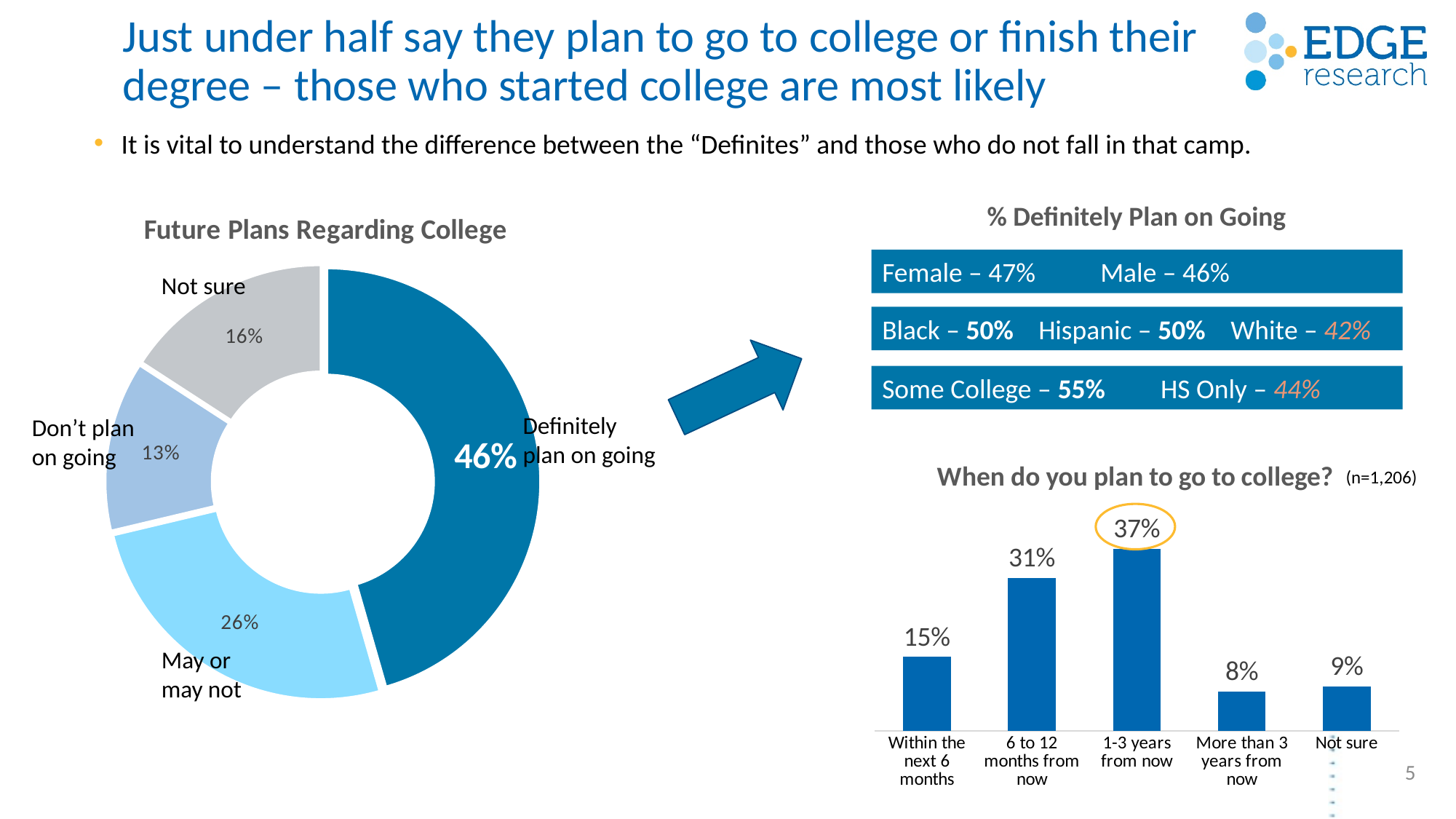
In the 'When do you plan to go to college?' chart, what is the difference between '1-3 years from now' and '6 to 12 months from now'? 6% What kind of chart is 'Future Plans Regarding College'? Doughnut (pie) chart In the 'When do you plan to go to college?' chart, what is the value for '1-3 years from now'? 37% In the 'Future Plans Regarding College' chart, what is the difference between 'Not sure' and 'Don't plan on going'? 3% In the 'When do you plan to go to college?' chart, which is larger: 'Within the next 6 months' or '6 to 12 months from now'? 6 to 12 months from now In the 'Future Plans Regarding College' chart, which category has the smallest share? Don't plan on going In the 'Future Plans Regarding College' chart, what percentage definitely plan on going? 46% In the 'Future Plans Regarding College' chart, how many categories are shown? 4 What kind of chart is 'When do you plan to go to college?'? Bar chart How many bars are in the 'When do you plan to go to college?' chart? 5 In the 'Future Plans Regarding College' chart, what percentage say 'May or may not'? 26% In the 'When do you plan to go to college?' chart, which category has the lowest value? More than 3 years from now